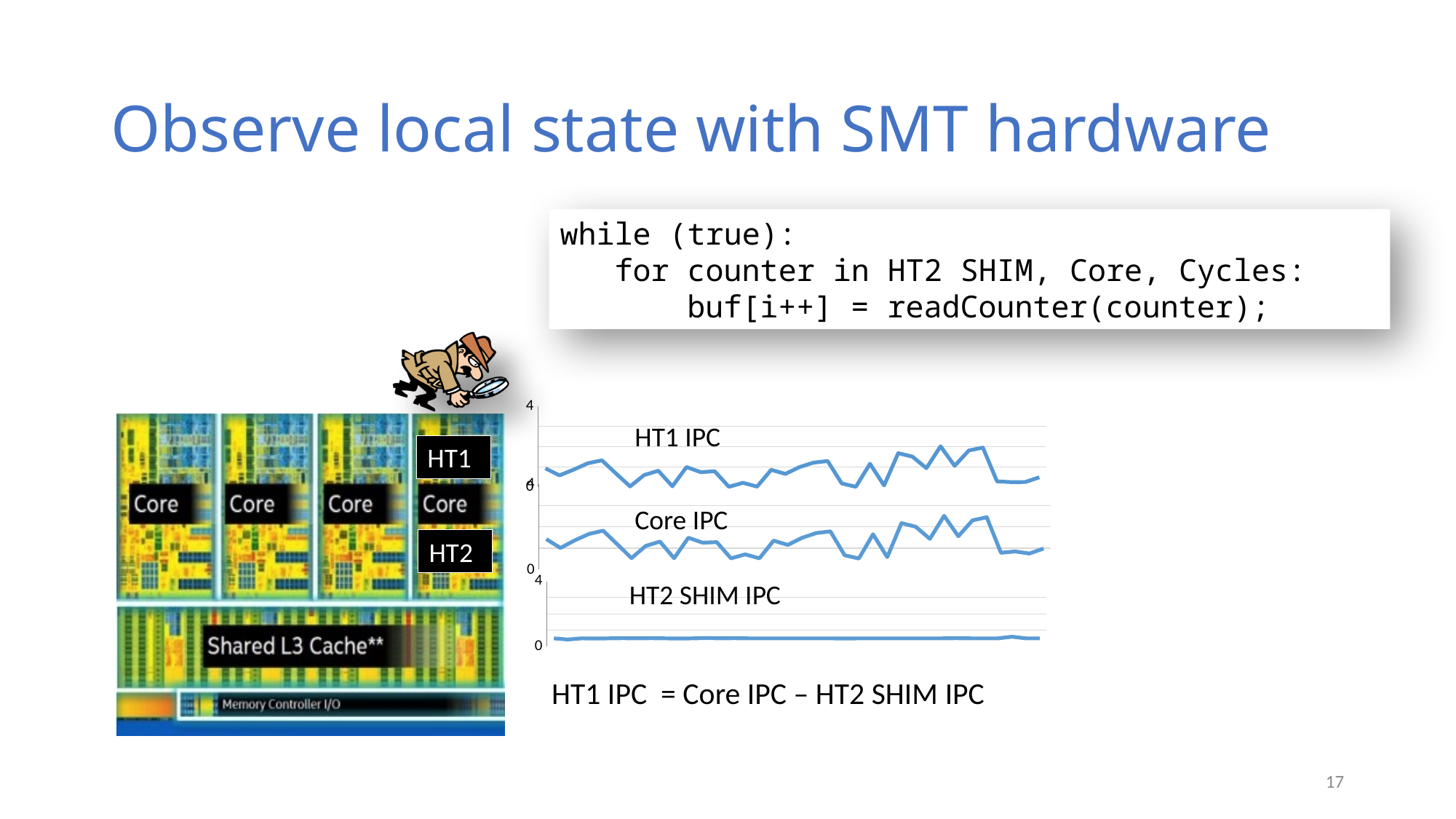
Which chart is positioned at the bottom of the three stacked charts? HT2 SHIM IPC What kind of chart is used to show HT1 IPC, Core IPC and HT2 SHIM IPC? line chart What is the maximum value labelled on the y axis of the HT1 IPC chart? 4 What is the minimum value labelled on the y axis of the HT2 SHIM IPC chart? 0 Are the values of the HT1 IPC line greater or less than 4? less How many separate line charts are shown on the slide? 3 Are the values of the HT2 SHIM IPC line greater or less than 4? less Which is higher overall, the Core IPC line or the HT2 SHIM IPC line? Core IPC Which is higher overall, the HT1 IPC line or the HT2 SHIM IPC line? HT1 IPC Are the values of the Core IPC line greater or less than 0? greater Does the HT2 SHIM IPC line fluctuate strongly or stay roughly flat along the x axis? roughly flat